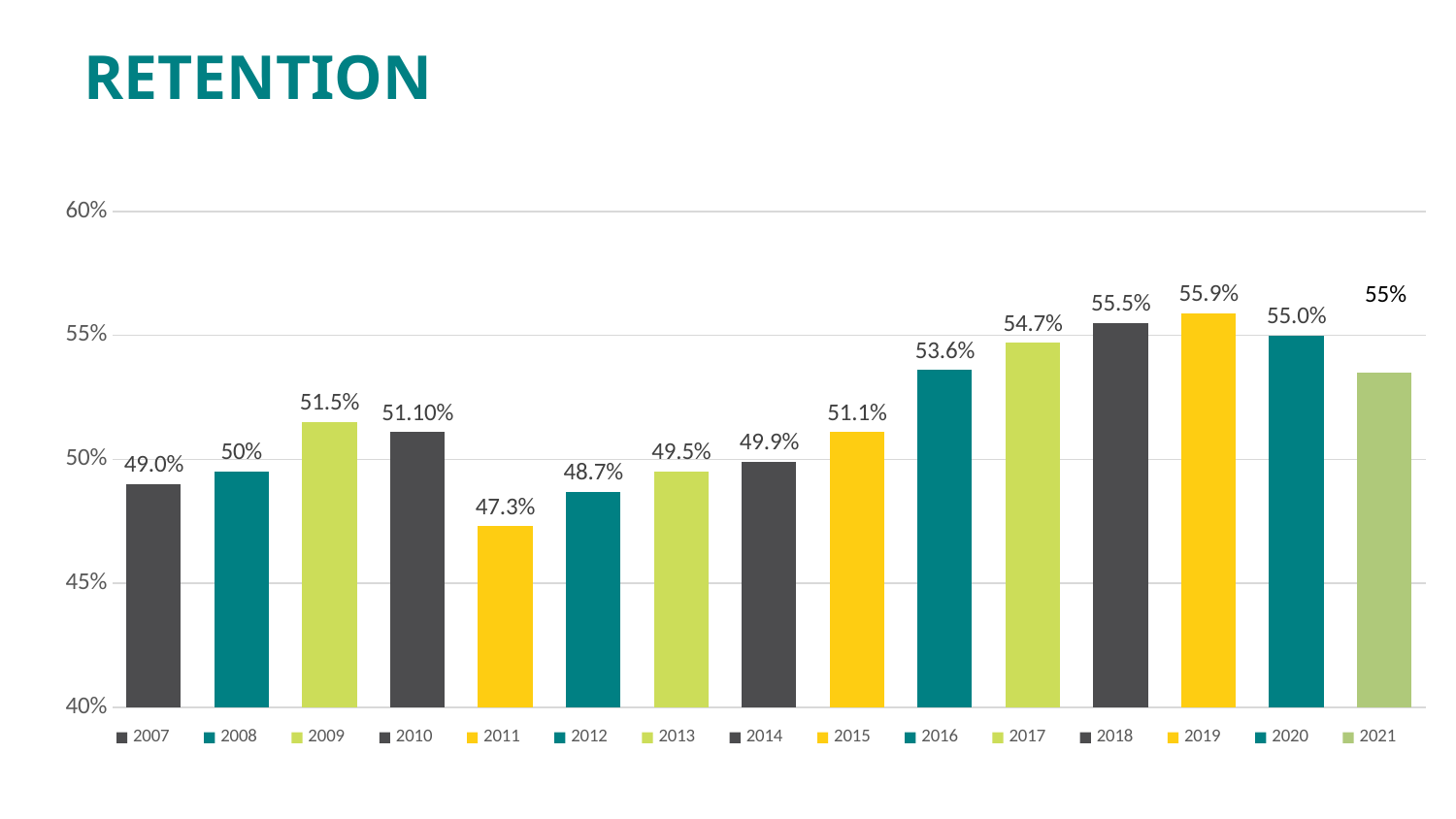
Which year has the lowest retention value? 2011 What is the retention value shown for 2011? 47.3% How many years are plotted in the chart? 15 Which year has the highest retention value? 2019 What is the difference between the retention values for 2019 and 2011? 8.6 percentage points What kind of chart is shown on the slide? Bar chart What is the retention value shown for 2019? 55.9% What is the retention value shown for 2016? 53.6% Which year has the larger retention value, 2016 or 2010? 2016 Is the value for 2011 greater or less than 50%? less Do the retention values rise or fall from 2015 to 2019? Rise What is the retention value shown for 2010? 51.10%